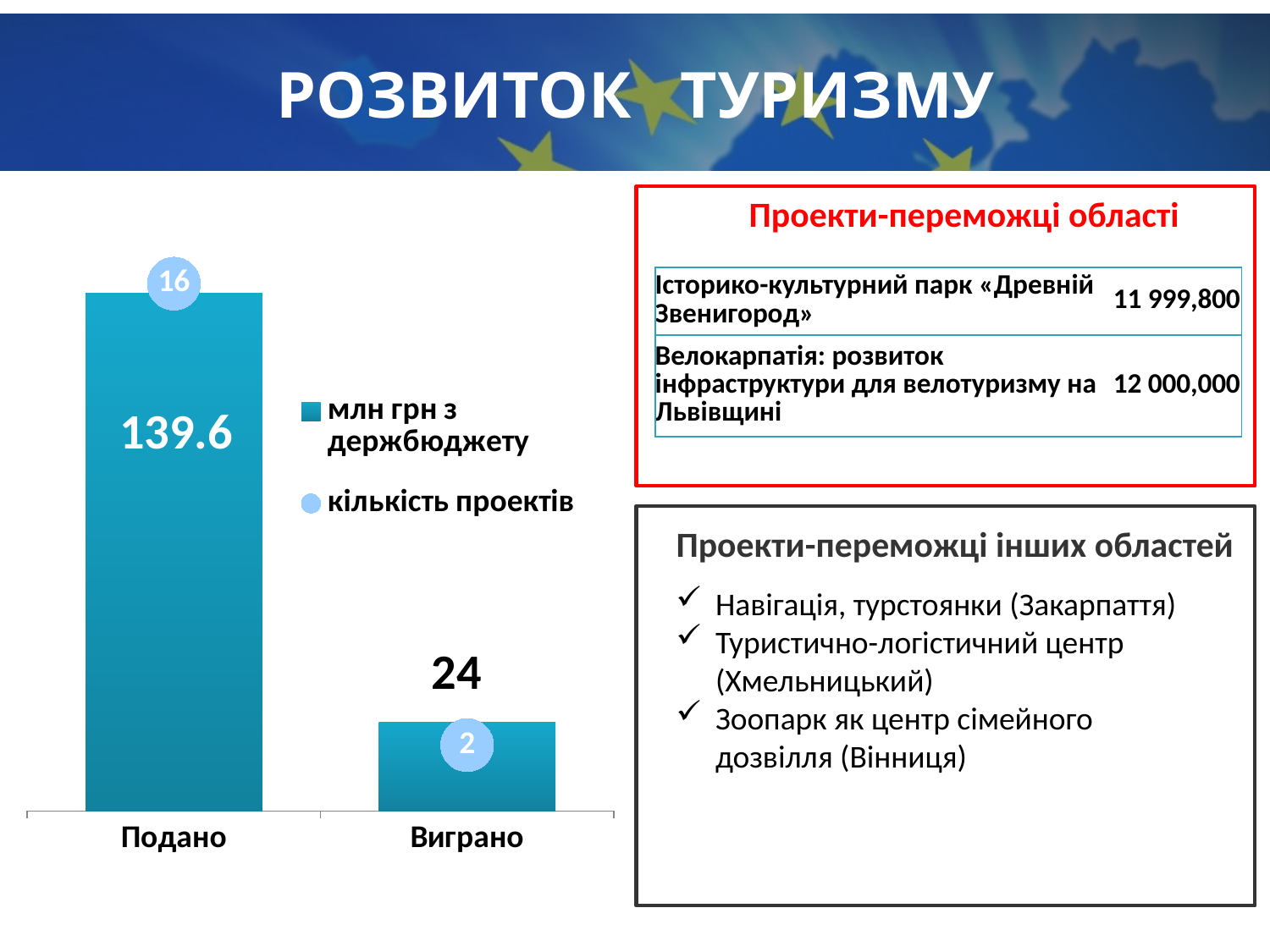
Which category has the higher value for "млн грн з держбюджету"? Подано What is the value of "кількість проектів" for "Подано"? 16 What type of chart is shown on the slide? bar chart What is the value of "млн грн з держбюджету" for "Подано"? 139.6 Is the "млн грн з держбюджету" value for "Подано" larger or smaller than the value for "Виграно"? larger What is the difference between the "кількість проектів" values for "Подано" and "Виграно"? 14 What is the difference between the "млн грн з держбюджету" values for "Подано" and "Виграно"? 115.6 How many series does the chart legend list? 2 What is the value of "кількість проектів" for "Виграно"? 2 How many categories are shown on the x axis of the chart? 2 Which category has the lower value for "кількість проектів"? Виграно What is the value of "млн грн з держбюджету" for "Виграно"? 24